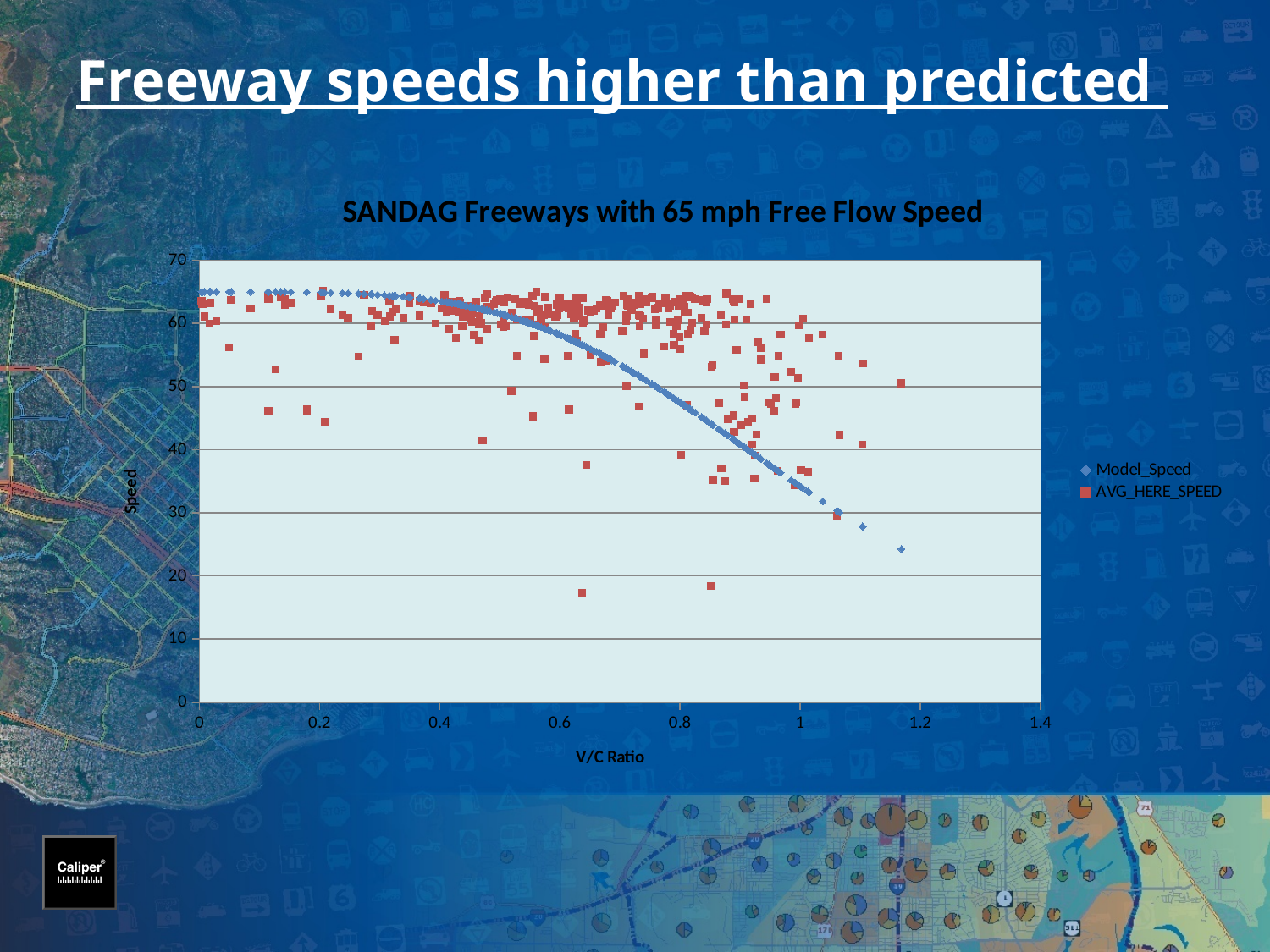
Which series is plotted with red square markers? AVG_HERE_SPEED How many series does the legend list? 2 Is the Model_Speed value at a V/C Ratio of 0.9 greater or less than 50? less Is the lowest AVG_HERE_SPEED value plotted greater or less than 20? less What is the highest value shown on the Speed axis? 70 Does the Model_Speed series rise or fall as the V/C Ratio increases? Fall Is the Model_Speed value at a V/C Ratio of 0.2 greater or less than 60? greater What kind of chart is shown on the slide? Scatter chart What is the title of the chart? SANDAG Freeways with 65 mph Free Flow Speed